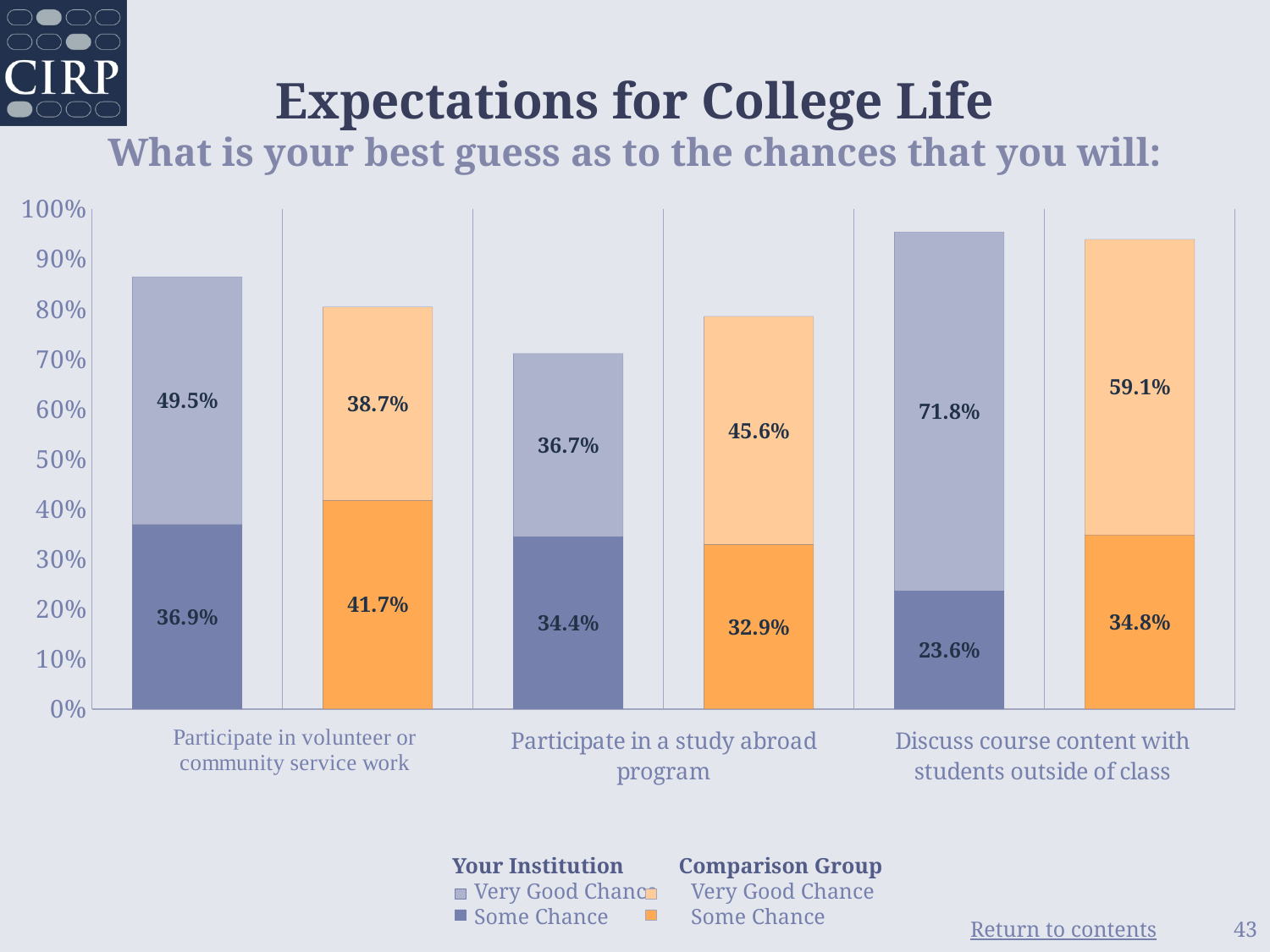
What is the combined total of the Comparison Group's bar for discussing course content with students outside of class? 93.9% What type of chart is shown on the slide? Stacked bar chart What is the difference between Your Institution's and the Comparison Group's Very Good Chance values for discussing course content with students outside of class? 12.7 percentage points Which Some Chance value is the lowest on the chart? 23.6% (Your Institution, Discuss course content with students outside of class) What percentage of Your Institution students said there is a Very Good Chance they will discuss course content with students outside of class? 71.8% Across all three categories, which Very Good Chance value is the highest? 71.8% (Your Institution, Discuss course content with students outside of class) What percentage of the Comparison Group said there is Some Chance they will participate in volunteer or community service work? 41.7% How many entries does the legend list? 4 For participating in a study abroad program, which group has the larger Very Good Chance value, Your Institution or the Comparison Group? Comparison Group What is the combined total (Some Chance plus Very Good Chance) of Your Institution's bar for participating in volunteer or community service work? 86.4% How many expectation categories are shown along the x axis? 3 What is the Comparison Group's Very Good Chance value for participating in a study abroad program? 45.6%